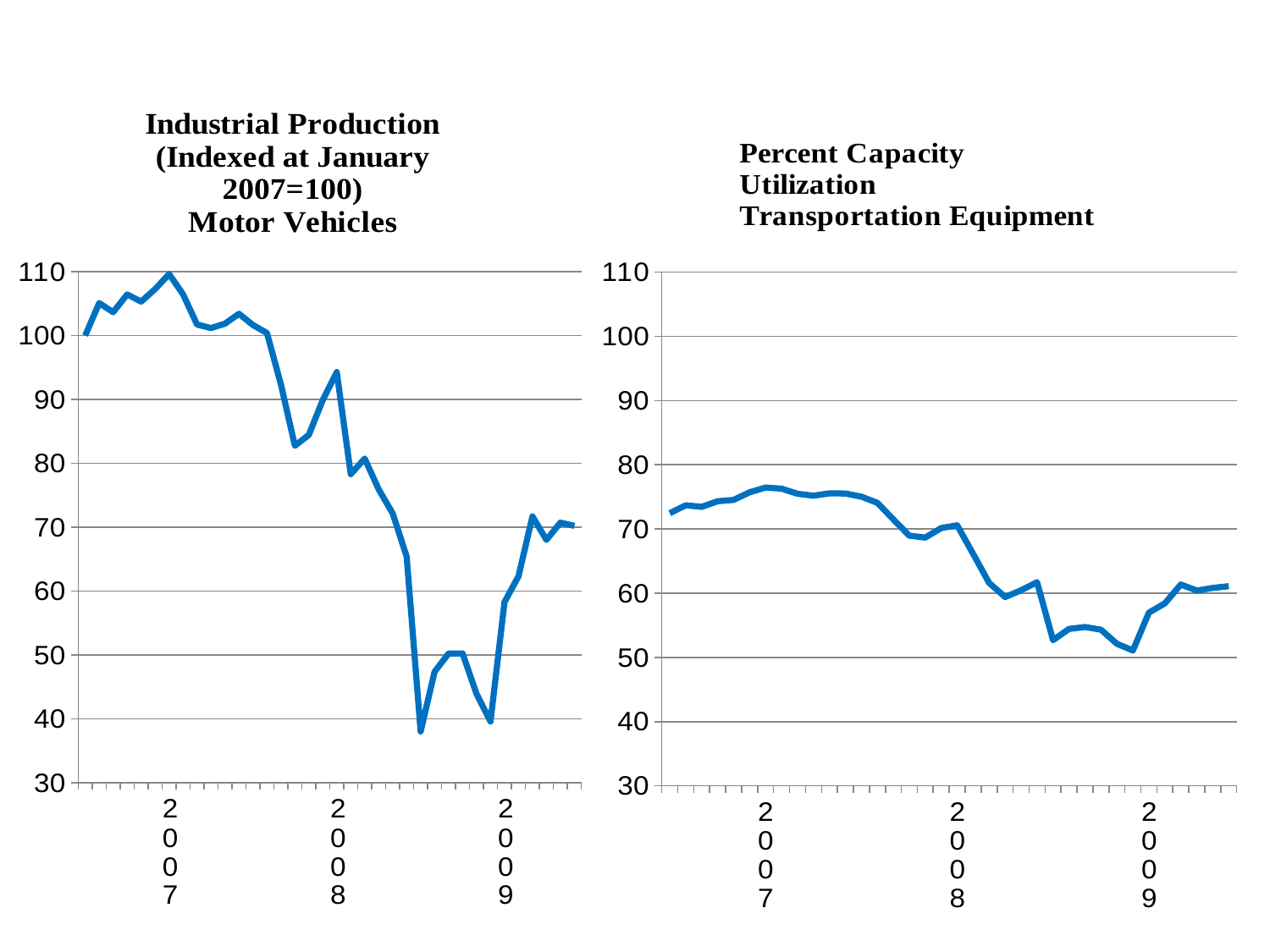
What is the title of the chart on the left of the slide? Industrial Production (Indexed at January 2007=100) Motor Vehicles What are the lowest and highest values shown on the vertical axis of the 'Percent Capacity Utilization' chart on the right? 30 and 110 On the 'Industrial Production' chart on the left, what is the value at January 2007, the base month of the index? 100 Which chart reaches a lower minimum value: the 'Industrial Production' chart on the left or the 'Percent Capacity Utilization' chart on the right? Industrial Production (left) On the 'Industrial Production' chart on the left, do the values overall rise or fall from 2007 to 2009? fall On the 'Percent Capacity Utilization' chart on the right, do the values overall rise or fall from 2007 to 2009? fall What kind of chart is the 'Percent Capacity Utilization Transportation Equipment' chart on the right of the slide? line chart On the 'Industrial Production' chart on the left, is the highest value on the line greater or less than 100? greater On the 'Percent Capacity Utilization' chart on the right, is the lowest value on the line greater or less than 60? less On the 'Percent Capacity Utilization' chart on the right, is the highest value on the line greater or less than 80? less What kind of chart is the 'Industrial Production' chart on the left of the slide? line chart